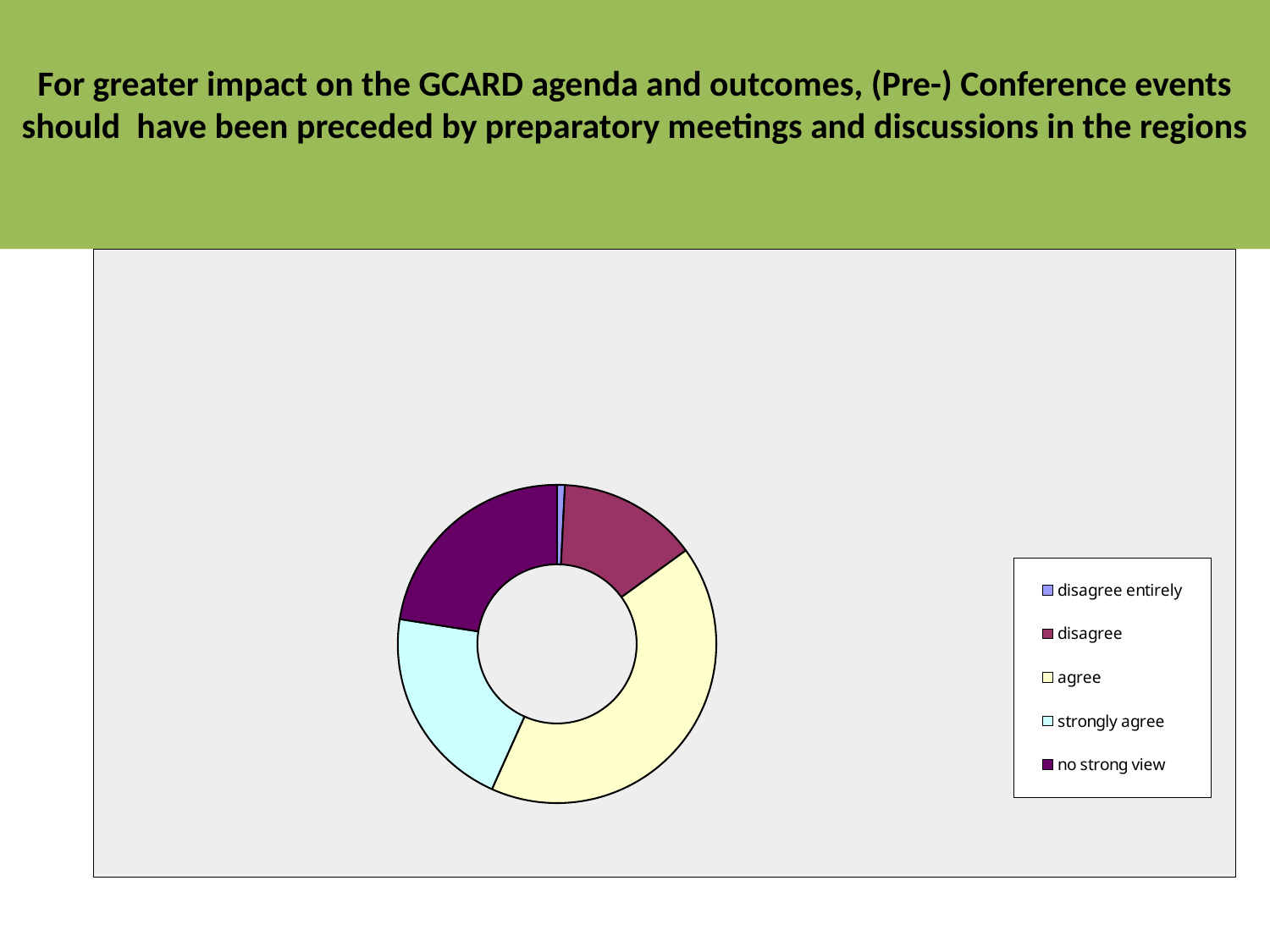
Which slice is larger, agree or disagree? agree What colour is the agree slice in the chart? pale yellow Which slice is larger, agree or no strong view? agree Which category has the smallest slice in the chart? disagree entirely Which slice is larger, no strong view or disagree entirely? no strong view How many categories does the chart's legend list? 5 Which legend entry is listed first in the chart's legend? disagree entirely What kind of chart is shown on the slide? doughnut chart Which category has the largest slice in the chart? agree